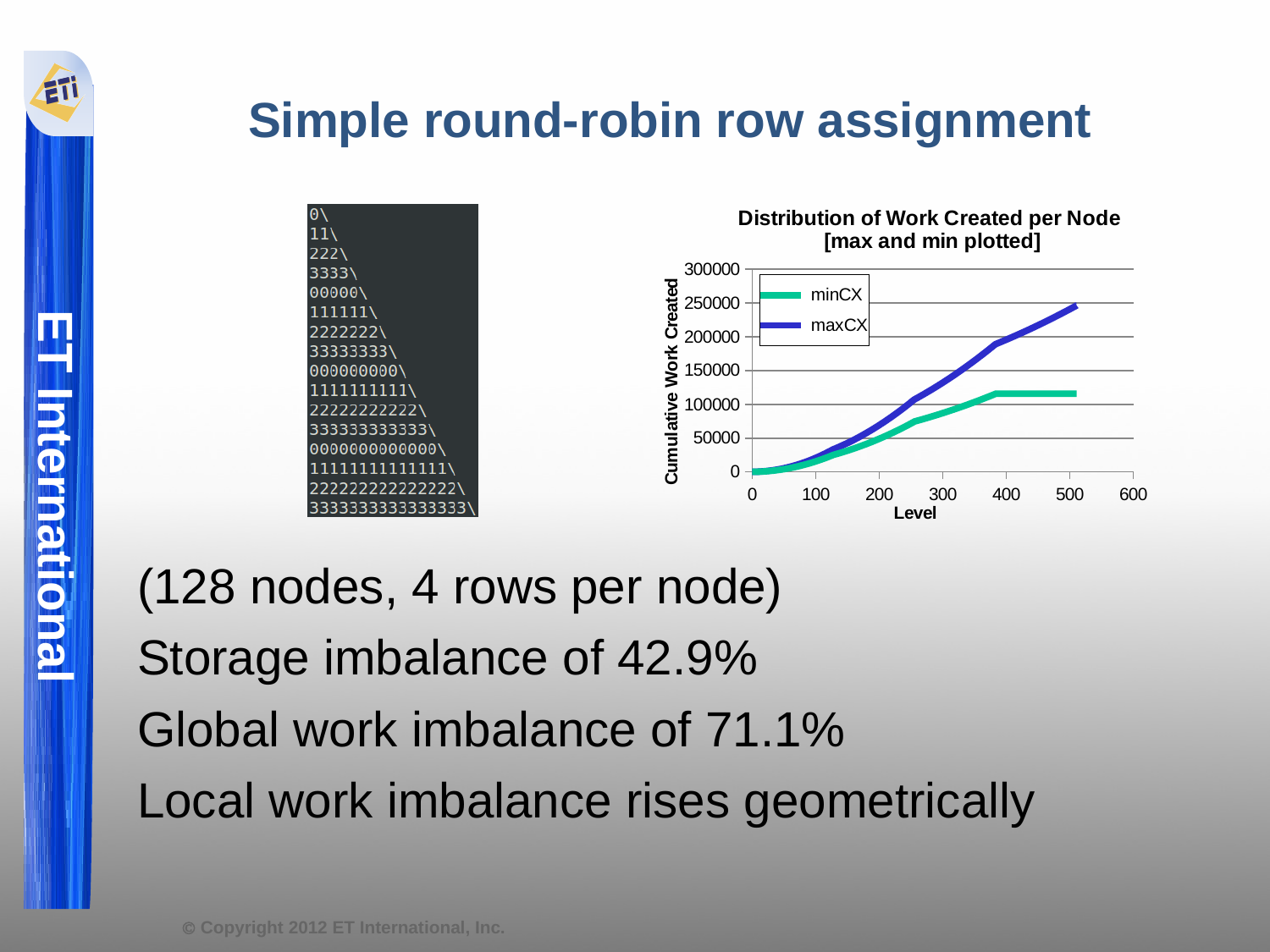
What are the two series named in the chart's legend? minCX and maxCX Do the minCX values rise or fall as Level increases? rise Which series is plotted in blue in the chart? maxCX Do the maxCX values rise or fall as Level increases? rise Is the maxCX value at Level 300 greater or less than 100000? greater Is the minCX value at Level 500 greater or less than 150000? less How many series does the legend of the chart list? 2 Is the minCX value at Level 400 greater or less than 100000? greater At Level 500, which series has the larger value, maxCX or minCX? maxCX What kind of chart is shown on the slide? line chart What is the title of the chart? Distribution of Work Created per Node [max and min plotted]